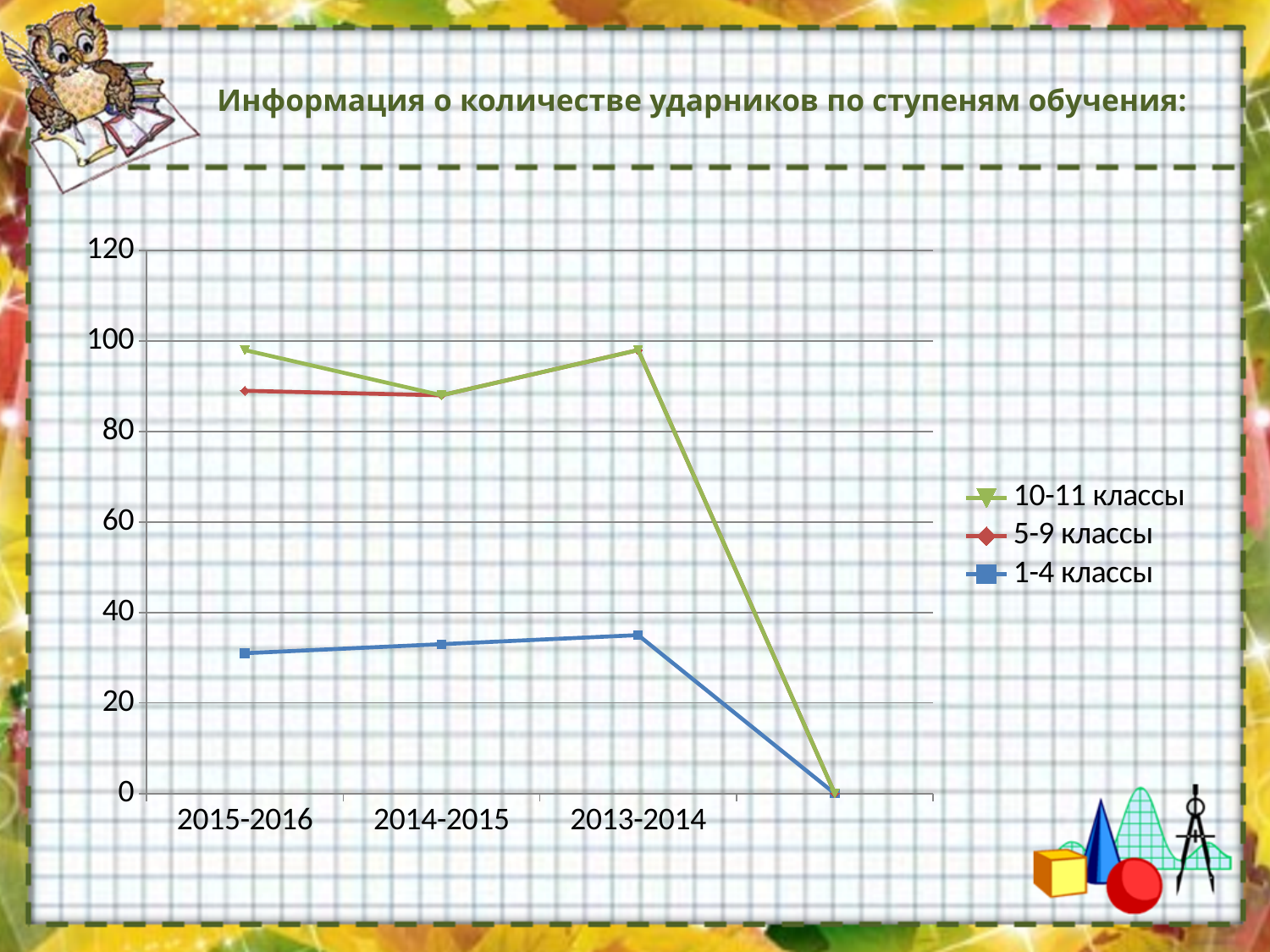
What kind of chart is shown on the slide? line chart What is the title of the chart? Информация о количестве ударников по ступеням обучения: Is the value for 1-4 классы in 2015-2016 greater or less than 40? less Does the line for 1-4 классы rise or fall from 2015-2016 to 2013-2014? rise How many series does the legend list? 3 Which series is drawn in blue? 1-4 классы Is the value for 1-4 классы in 2013-2014 greater or less than 40? less